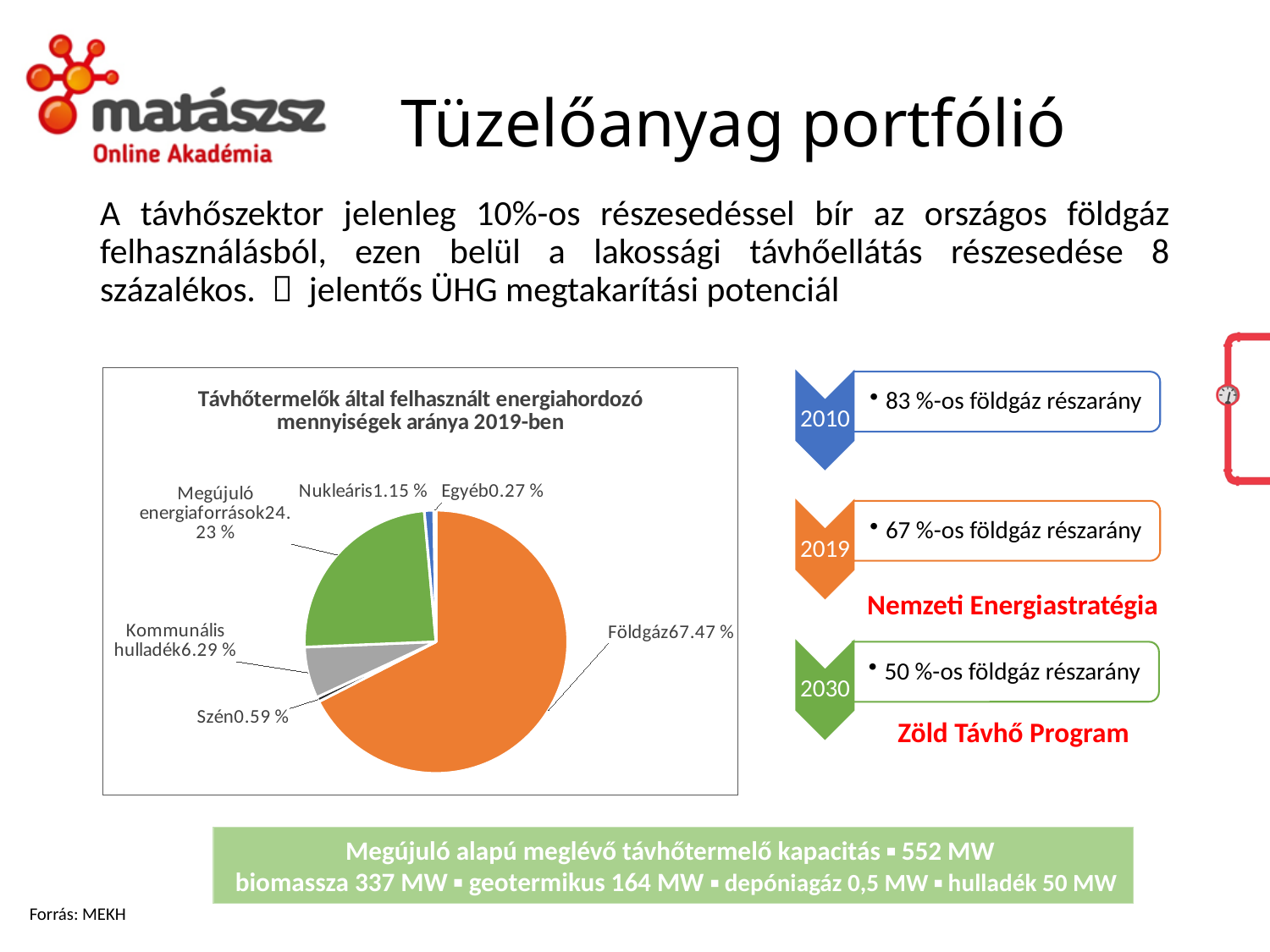
Which is larger in the pie chart, Kommunális hulladék or Nukleáris? Kommunális hulladék Which category has the largest slice in the pie chart? Földgáz What is the share of Kommunális hulladék in the pie chart? 6.29 % What is the share of Megújuló energiaforrások in the pie chart? 24.23 % What is the share of Egyéb in the pie chart? 0.27 % What is the title of the pie chart? Távhőtermelők által felhasznált energiahordozó mennyiségek aránya 2019-ben How many slices does the pie chart have? 6 What is the share of Nukleáris in the pie chart? 1.15 % What type of chart is shown on the slide? pie chart Which category has the smallest slice in the pie chart? Egyéb What is the share of Szén in the pie chart? 0.59 % What is the share of Földgáz in the pie chart? 67.47 %